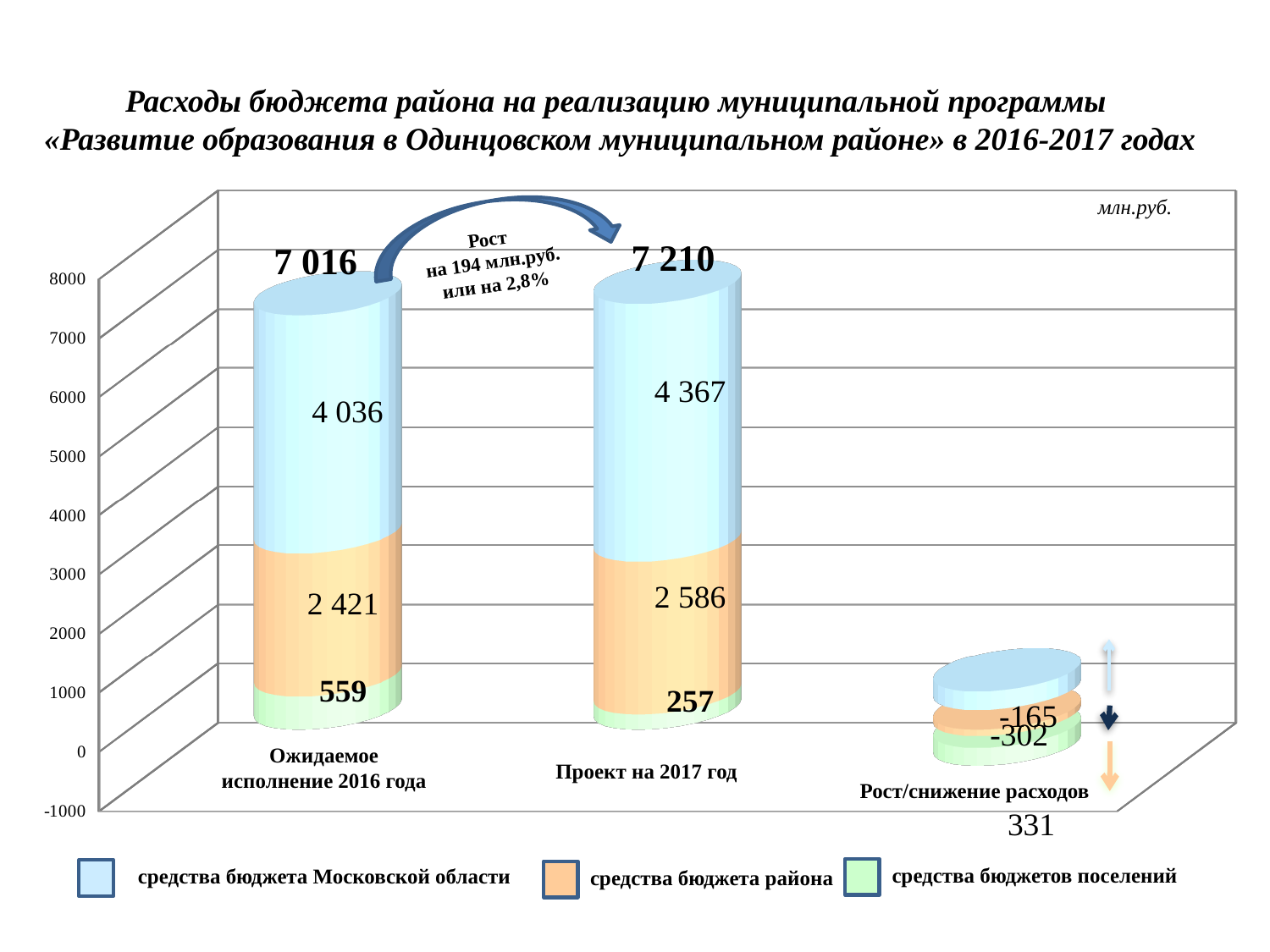
Which series has the lowest value in Проект на 2017 год? средства бюджетов поселений What unit of measurement is indicated on the chart? млн.руб. What is the value for средства бюджета района in Проект на 2017 год? 2 586 What is the total of the stacked bar for Ожидаемое исполнение 2016 года? 7 016 How many series does the legend list? 3 Which is larger: средства бюджета района in Ожидаемое исполнение 2016 года or in Проект на 2017 год? Проект на 2017 год What is the value for средства бюджетов поселений in Проект на 2017 год? 257 What is the difference between средства бюджета Московской области in Проект на 2017 год and in Ожидаемое исполнение 2016 года? 331 What is the value for средства бюджетов поселений in Ожидаемое исполнение 2016 года? 559 What is the total of the stacked bar for Проект на 2017 год? 7 210 What kind of chart is shown on the slide? Stacked bar chart What is the value for средства бюджета Московской области in Ожидаемое исполнение 2016 года? 4 036